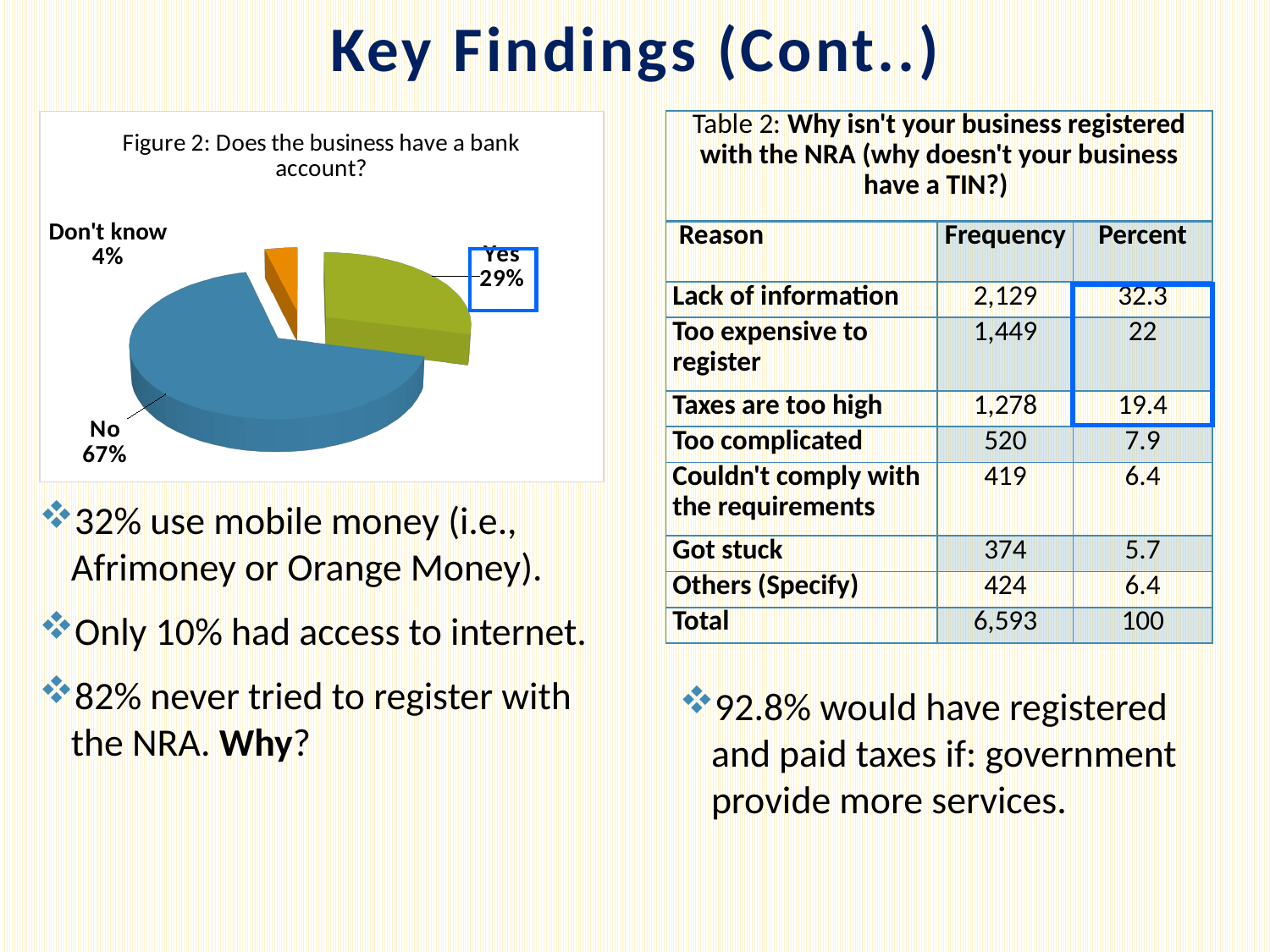
In Figure 2, how many slices does the pie chart have? 3 In Figure 2, what percentage of businesses answered "Yes"? 29% In Figure 2, what percentage of businesses answered "No"? 67% In Figure 2, what is the difference in percentage points between the "No" and "Yes" slices? 38 In Figure 2, which response has the smallest slice? Don't know In Figure 2, what percentage of businesses answered "Don't know"? 4% What is the title of the pie chart on the slide? Figure 2: Does the business have a bank account? In Figure 2, which response has the largest slice? No In Figure 2, what share of the pie does the "No" slice represent? 67% What kind of chart is Figure 2? pie chart In Figure 2, which slice is larger, "Yes" or "Don't know"? Yes In Figure 2, what colour is the "No" slice? blue